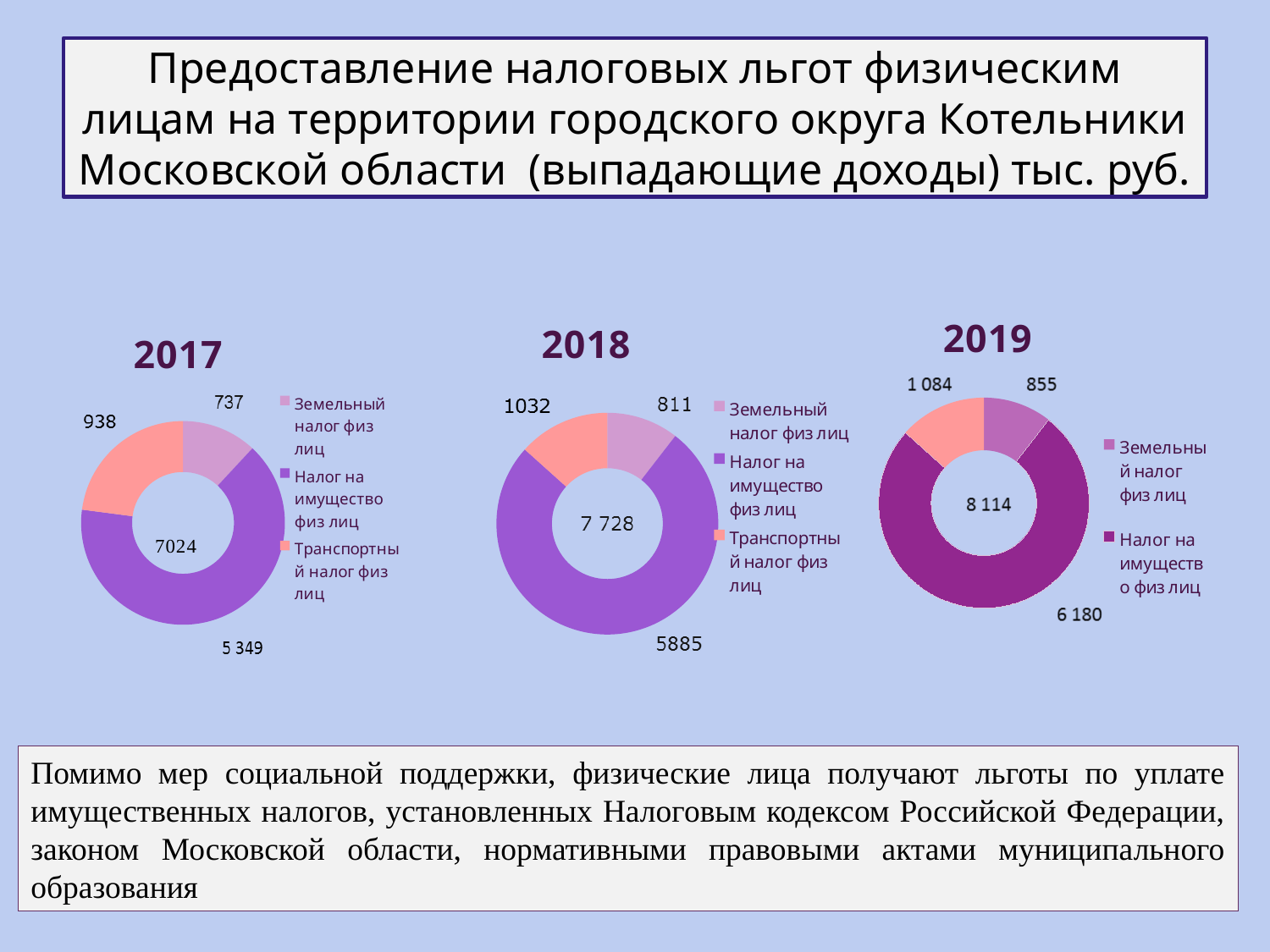
In the 2018 chart, what is the value for Земельный налог физ лиц? 811 What total is shown in the centre of the 2018 chart? 7 728 In the 2017 chart, what is the value for Транспортный налог физ лиц? 938 In the 2018 chart, what is the difference between Транспортный налог физ лиц and Земельный налог физ лиц? 221 In the 2019 chart, what is the value for Налог на имущество физ лиц? 6 180 In the 2018 chart, which category has the largest value? Налог на имущество физ лиц In the 2017 chart, which category has the smallest value? Земельный налог физ лиц In the 2019 chart, which is larger: the value labelled 1 084 or the value labelled 855? 1 084 What total is shown in the centre of the 2019 chart? 8 114 In the 2017 chart, what is the value for Налог на имущество физ лиц? 5 349 What type of chart is used for the 2017 data? Doughnut (pie) chart How many slices does the 2017 chart have? 3